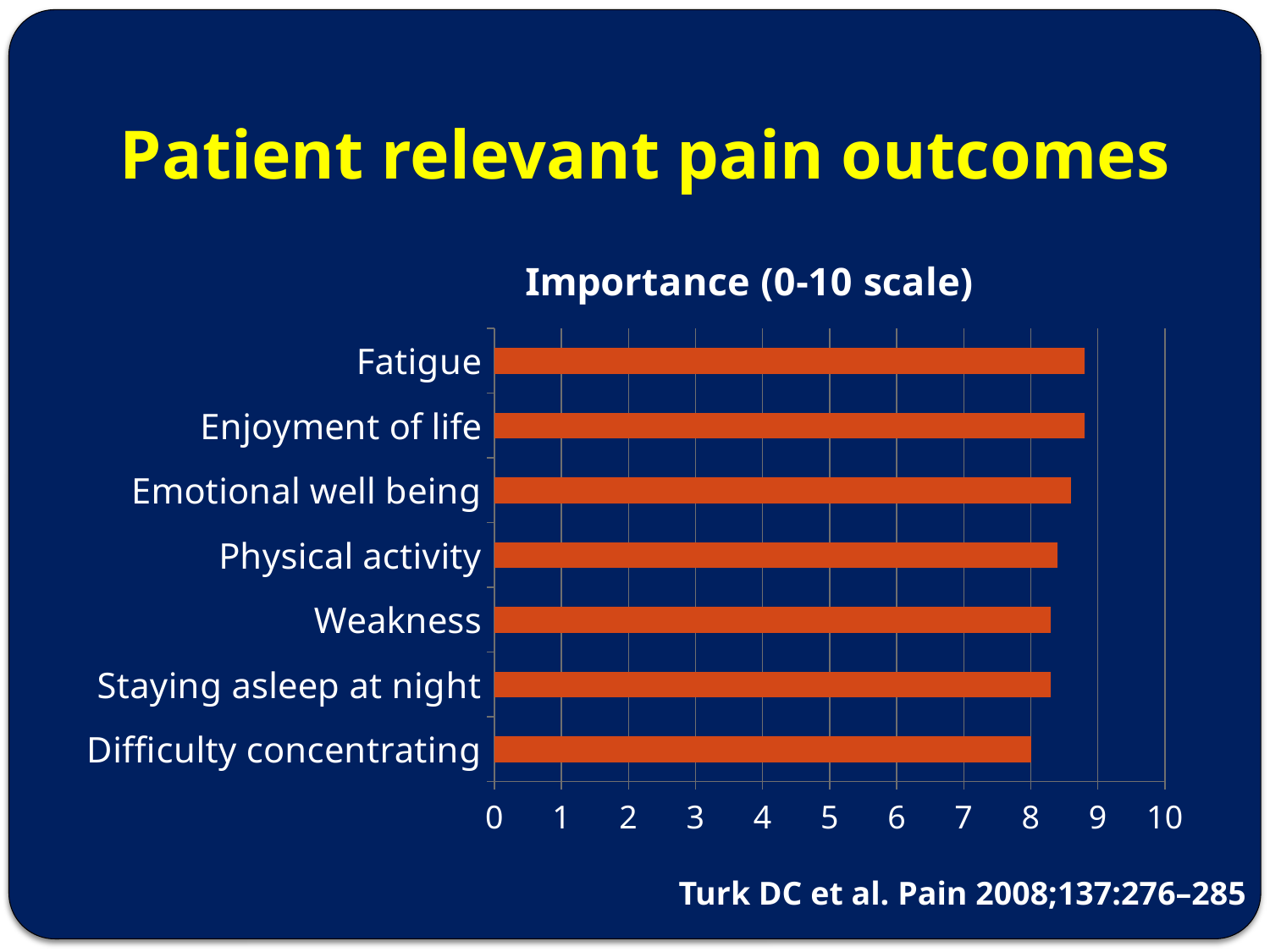
Which has a higher importance rating, Emotional well being or Difficulty concentrating? Emotional well being Is the importance value for Enjoyment of life greater or less than 9? less Which has a higher importance rating, Fatigue or Physical activity? Fatigue Is the importance value for Fatigue greater or less than 8? greater How many categories (outcomes) are plotted in the chart? 7 What kind of chart is shown on the slide? bar chart What is the title shown above the chart? Importance (0-10 scale) Which outcome has the lowest importance rating in the chart? Difficulty concentrating Is the importance value for Weakness greater or less than 9? less Which has a higher importance rating, Fatigue or Difficulty concentrating? Fatigue What is the maximum value shown on the chart's horizontal axis? 10 What is the importance value for Difficulty concentrating? 8